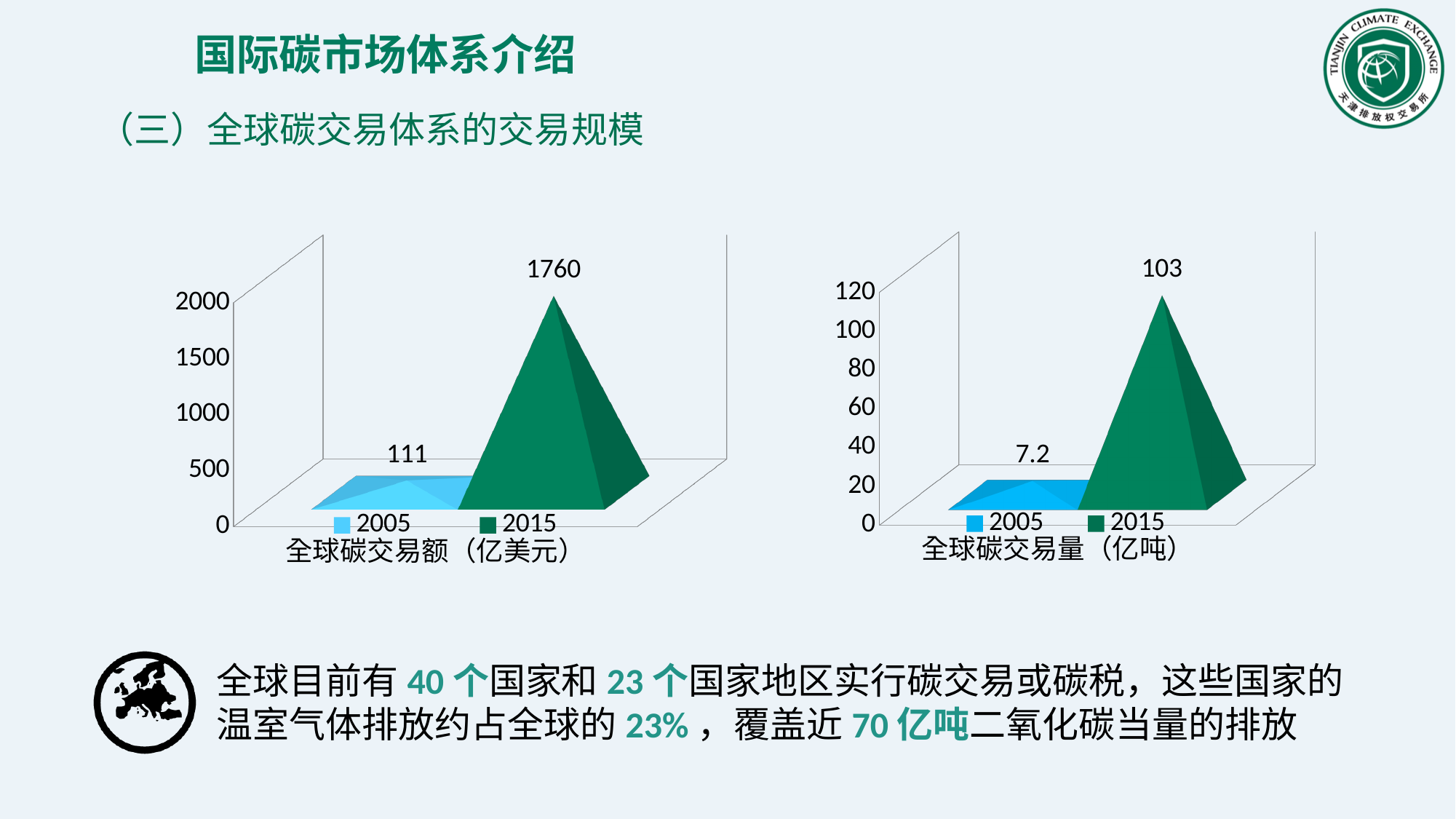
What is the x-axis label of the left chart? 全球碳交易额（亿美元） In the left chart (全球碳交易额（亿美元）), what is the value for 2005? 111 How many series does the legend of the right chart (全球碳交易量（亿吨）) list? 2 In the right chart (全球碳交易量（亿吨）), which year has the lower value? 2005 In the left chart (全球碳交易额（亿美元）), which year has the higher value? 2015 In the right chart (全球碳交易量（亿吨）), what is the difference between the 2015 and 2005 values? 95.8 In the right chart (全球碳交易量（亿吨）), is the value for 2005 greater or less than 20? less In the left chart (全球碳交易额（亿美元）), what is the value for 2015? 1760 In the left chart (全球碳交易额（亿美元）), what is the difference between the 2015 and 2005 values? 1649 In the right chart (全球碳交易量（亿吨）), what is the value for 2005? 7.2 In the right chart (全球碳交易量（亿吨）), what is the value for 2015? 103 In the left chart (全球碳交易额（亿美元）), is the value for 2015 greater or less than 1500? greater